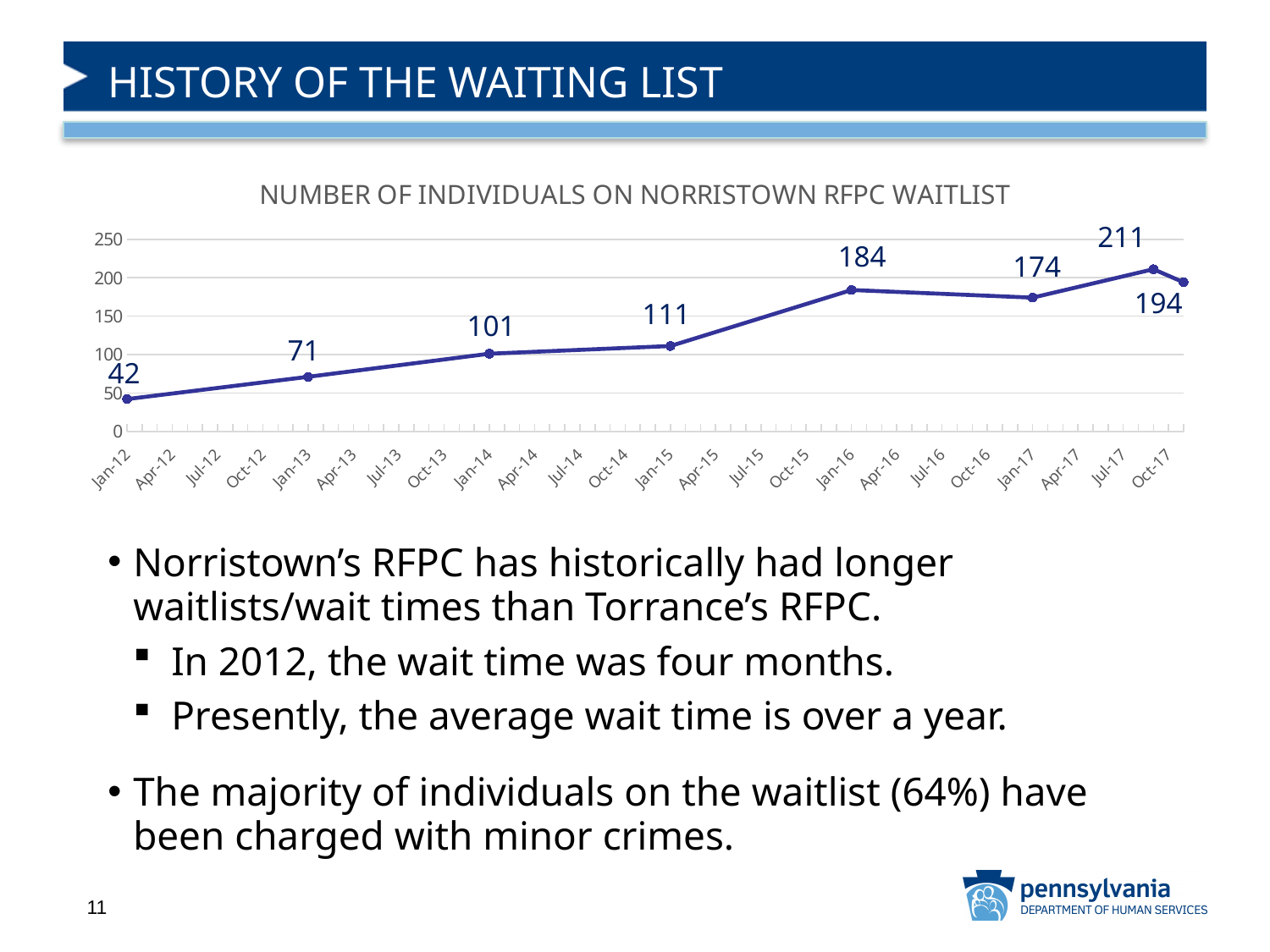
How many individuals were on the Norristown RFPC waitlist in Jan-12? 42 What is the highest labelled value on the chart? 211 What kind of chart is shown on the slide? line chart What value is labelled for Jan-17 on the chart? 174 What is the lowest labelled value on the chart? 42 What value is labelled for Jan-16 on the chart? 184 How many labelled data points are plotted on the line? 8 What is the difference between the Jan-16 value (184) and the Jan-15 value (111)? 73 Overall, does the number of individuals on the waitlist rise or fall from Jan-12 to Oct-17? rise What value is labelled for Jan-13 on the chart? 71 What is the title of the chart? NUMBER OF INDIVIDUALS ON NORRISTOWN RFPC WAITLIST Which is larger, the value for Jan-14 or the value for Jan-15? Jan-15